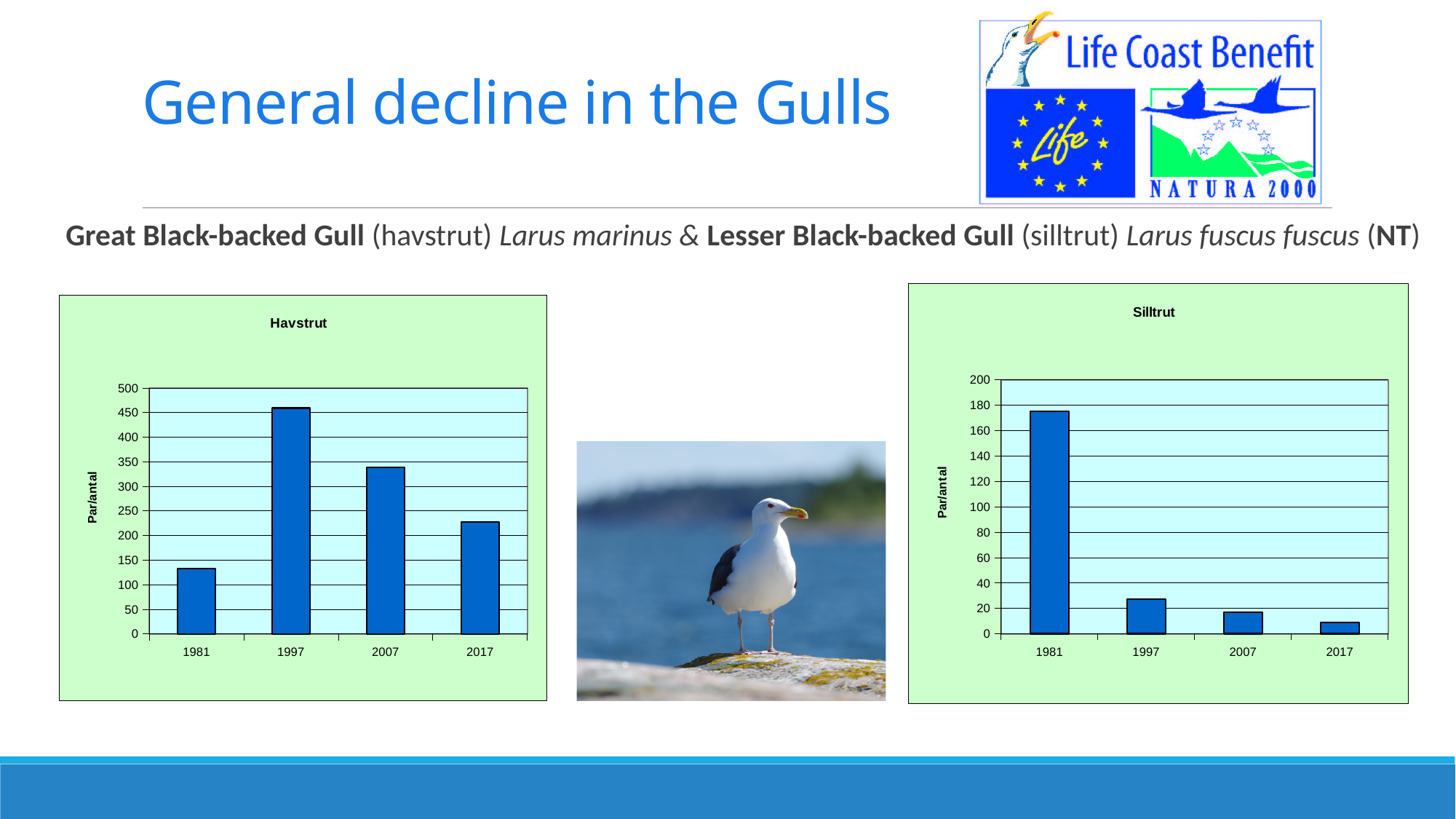
In the Silltrut chart, do the values rise or fall from 1981 to 2017? fall In the Havstrut chart, which year has the highest value? 1997 In the Silltrut chart, which year has the lowest value? 2017 What is the y-axis label on the Havstrut chart? Par/antal In the Havstrut chart, is the value for 2017 greater or less than 250? less How many years are shown on the x axis of the Havstrut chart? 4 In the Silltrut chart, is the value for 1981 greater or less than 160? greater In the Havstrut chart, is the value for 1997 greater or less than 400? greater What kind of chart is the Silltrut chart? bar chart In the Silltrut chart, which year has the highest value? 1981 In the Havstrut chart, which is larger, the value for 2007 or the value for 2017? 2007 In the Havstrut chart, which year has the lowest value? 1981